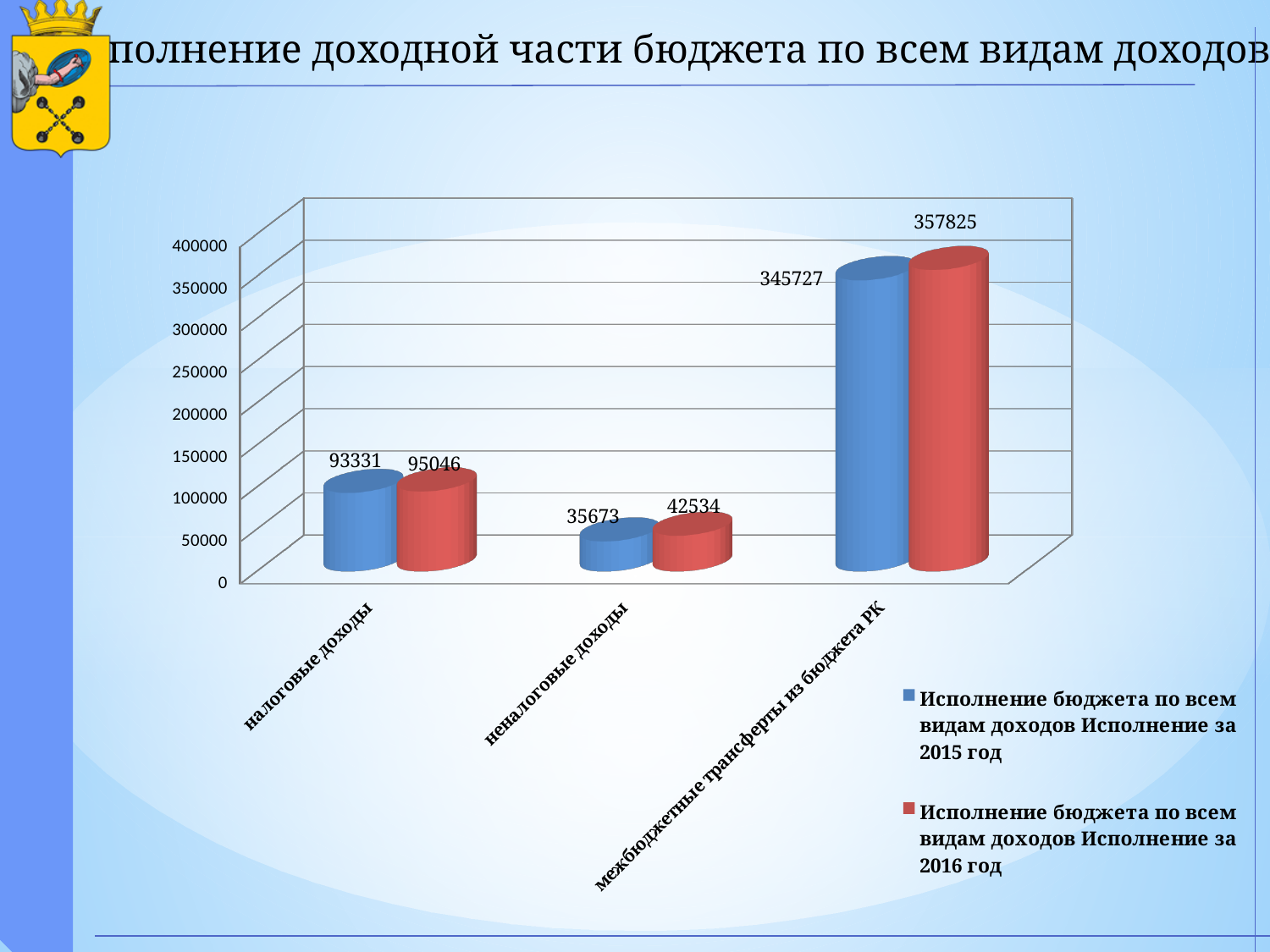
What is the value for налоговые доходы in the 2015 series (Исполнение за 2015 год)? 93331 What kind of chart is shown on the slide? bar chart How many categories are shown on the x axis? 3 Which category has the highest value in the 2015 series? межбюджетные трансферты из бюджета РК Is the 2015 value for межбюджетные трансферты из бюджета РК greater or less than 300000? greater What is the difference between the 2016 and 2015 values for межбюджетные трансферты из бюджета РК? 12098 Which is larger for налоговые доходы: the 2015 value or the 2016 value? 2016 value (95046) Which category has the lowest value in the 2016 series? неналоговые доходы What is the value for неналоговые доходы in the 2016 series (Исполнение за 2016 год)? 42534 What is the value for межбюджетные трансферты из бюджета РК in the 2016 series? 357825 What is the difference between the 2016 and 2015 values for неналоговые доходы? 6861 How many series does the legend list? 2